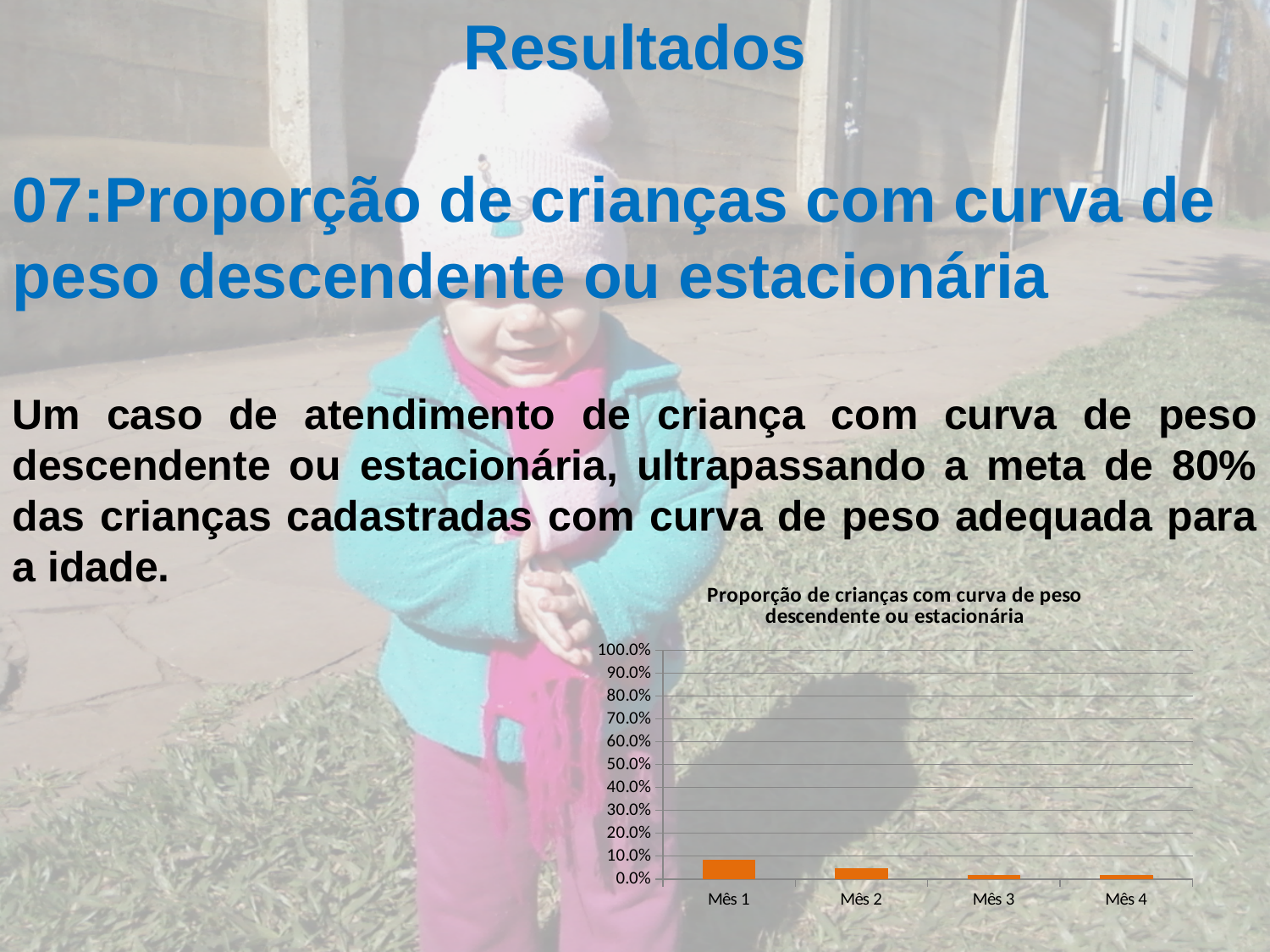
Which is larger, the value for Mês 1 or the value for Mês 2? Mês 1 What is the highest value shown on the y axis of the chart? 100.0% Is the value for Mês 2 greater or less than 10.0%? less What kind of chart is shown on the slide? bar chart Do the values in the chart generally rise or fall from Mês 1 to Mês 4? fall Is the value for Mês 1 greater or less than 10.0%? less How many categories (months) are shown on the x axis of the chart? 4 Is the value for Mês 1 greater or less than 80.0%? less Which is larger, the value for Mês 2 or the value for Mês 3? Mês 2 What is the title of the chart? Proporção de crianças com curva de peso descendente ou estacionária Which month has the highest value in the chart? Mês 1